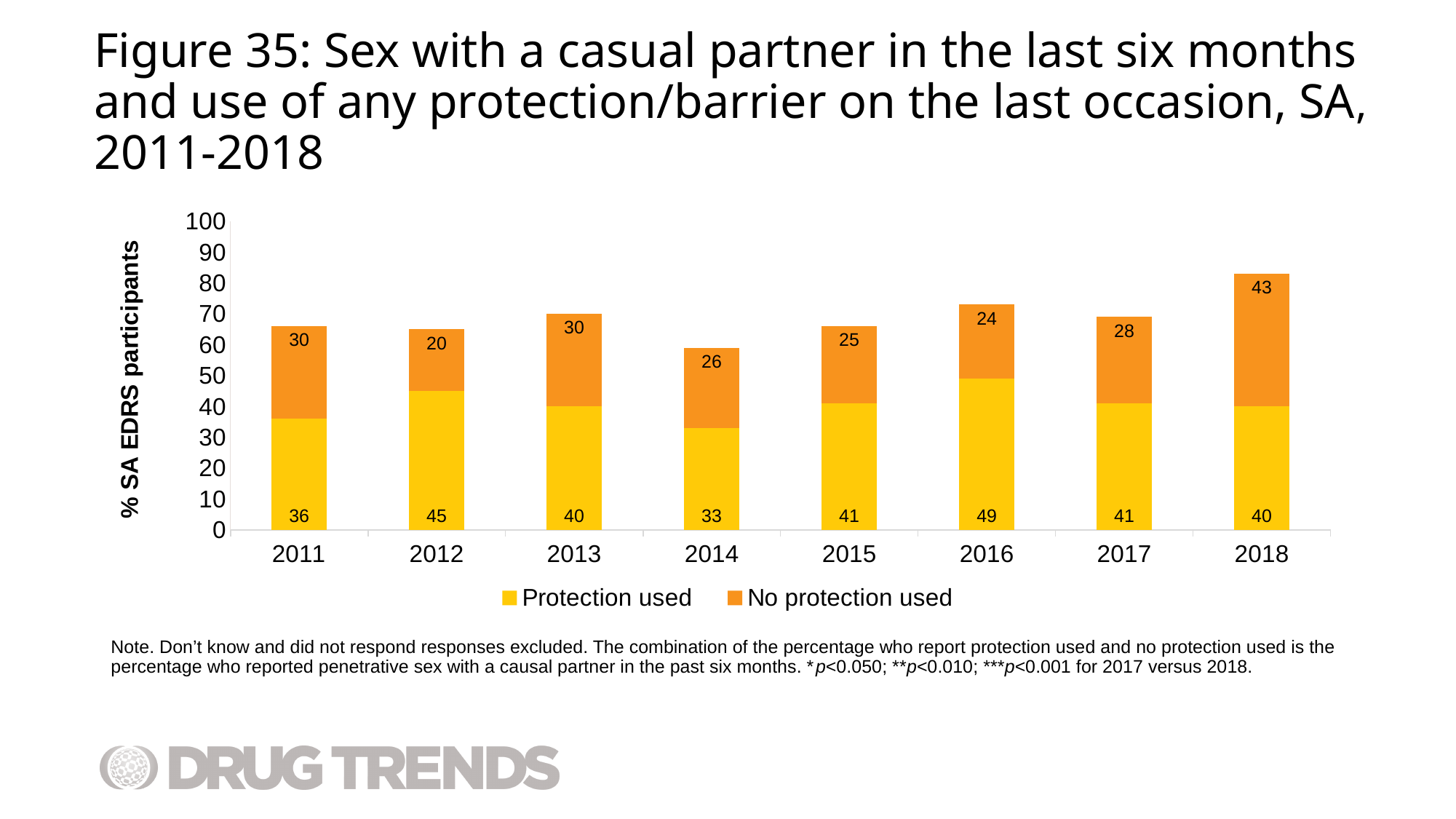
What is the value for 'Protection used' in 2016? 49 What is the total of the stacked bar for 2018? 83 What is the difference between the 'Protection used' values for 2016 and 2014? 16 What is the total of the stacked bar for 2014? 59 What is the value for 'Protection used' in 2014? 33 How many series does the legend list? 2 Which year has the highest value for 'No protection used'? 2018 How many years are shown on the x axis? 8 What kind of chart is shown on the slide? Stacked bar chart Which year has the lowest value for 'Protection used'? 2014 Which is larger: 'No protection used' in 2011 or in 2012? 2011 What is the value for 'No protection used' in 2018? 43